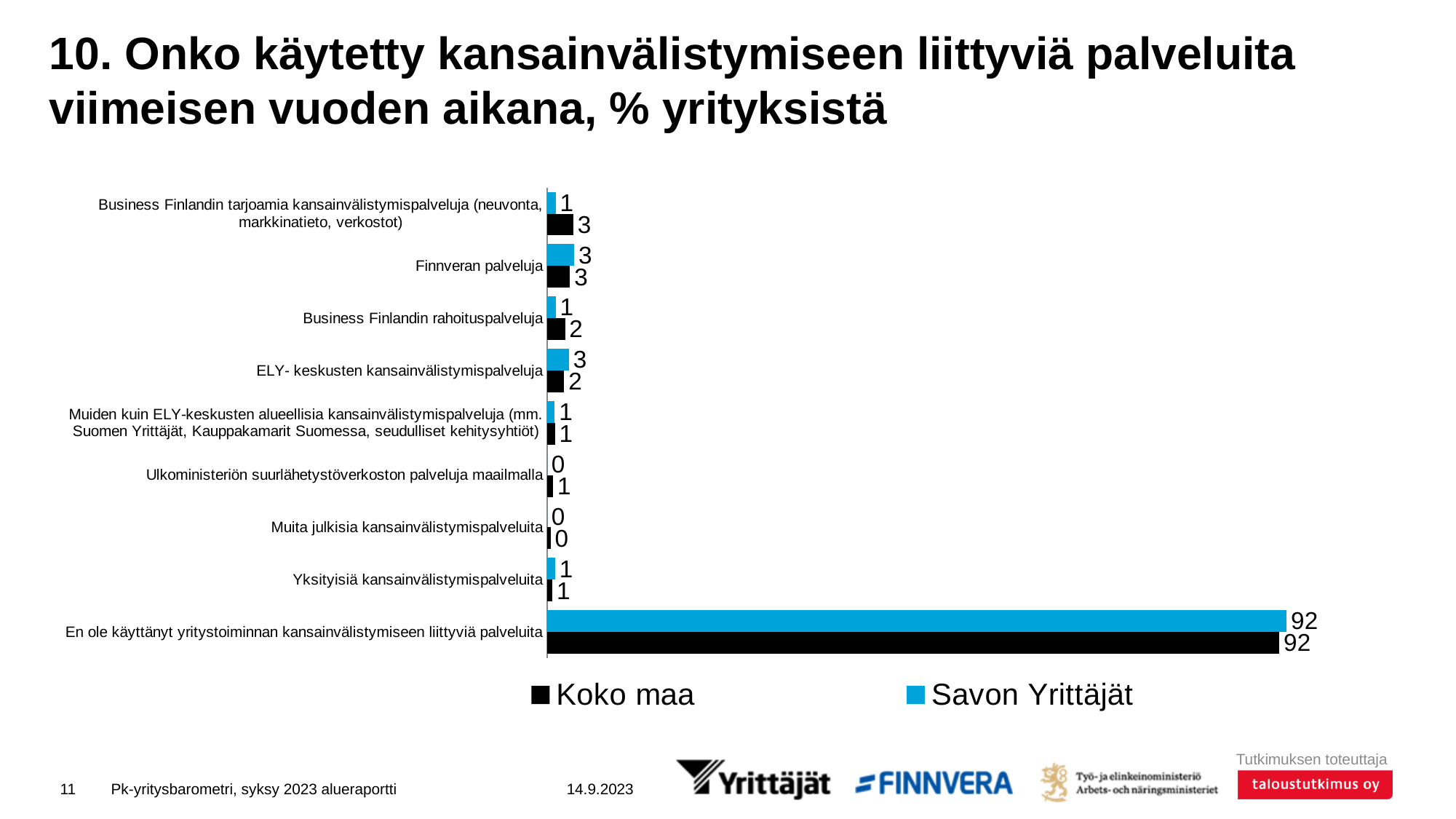
How many categories are plotted in the chart? 9 Which colour represents the Savon Yrittäjät series in the chart? blue What type of chart is shown on the slide? bar chart Which category has the highest value for Savon Yrittäjät? En ole käyttänyt yritystoiminnan kansainvälistymiseen liittyviä palveluita For 'Business Finlandin rahoituspalveluja', which series has the larger value, Koko maa or Savon Yrittäjät? Koko maa What is the value for Savon Yrittäjät for 'ELY- keskusten kansainvälistymispalveluja'? 3 For 'ELY- keskusten kansainvälistymispalveluja', which series has the larger value, Koko maa or Savon Yrittäjät? Savon Yrittäjät What is the value for Koko maa for 'En ole käyttänyt yritystoiminnan kansainvälistymiseen liittyviä palveluita'? 92 What is the value for Savon Yrittäjät for 'Ulkoministeriön suurlähetystöverkoston palveluja maailmalla'? 0 What is the value for Koko maa for 'Business Finlandin tarjoamia kansainvälistymispalveluja (neuvonta, markkinatieto, verkostot)'? 3 How many series does the legend list? 2 What is the difference between the Koko maa and Savon Yrittäjät values for 'Business Finlandin tarjoamia kansainvälistymispalveluja (neuvonta, markkinatieto, verkostot)'? 2